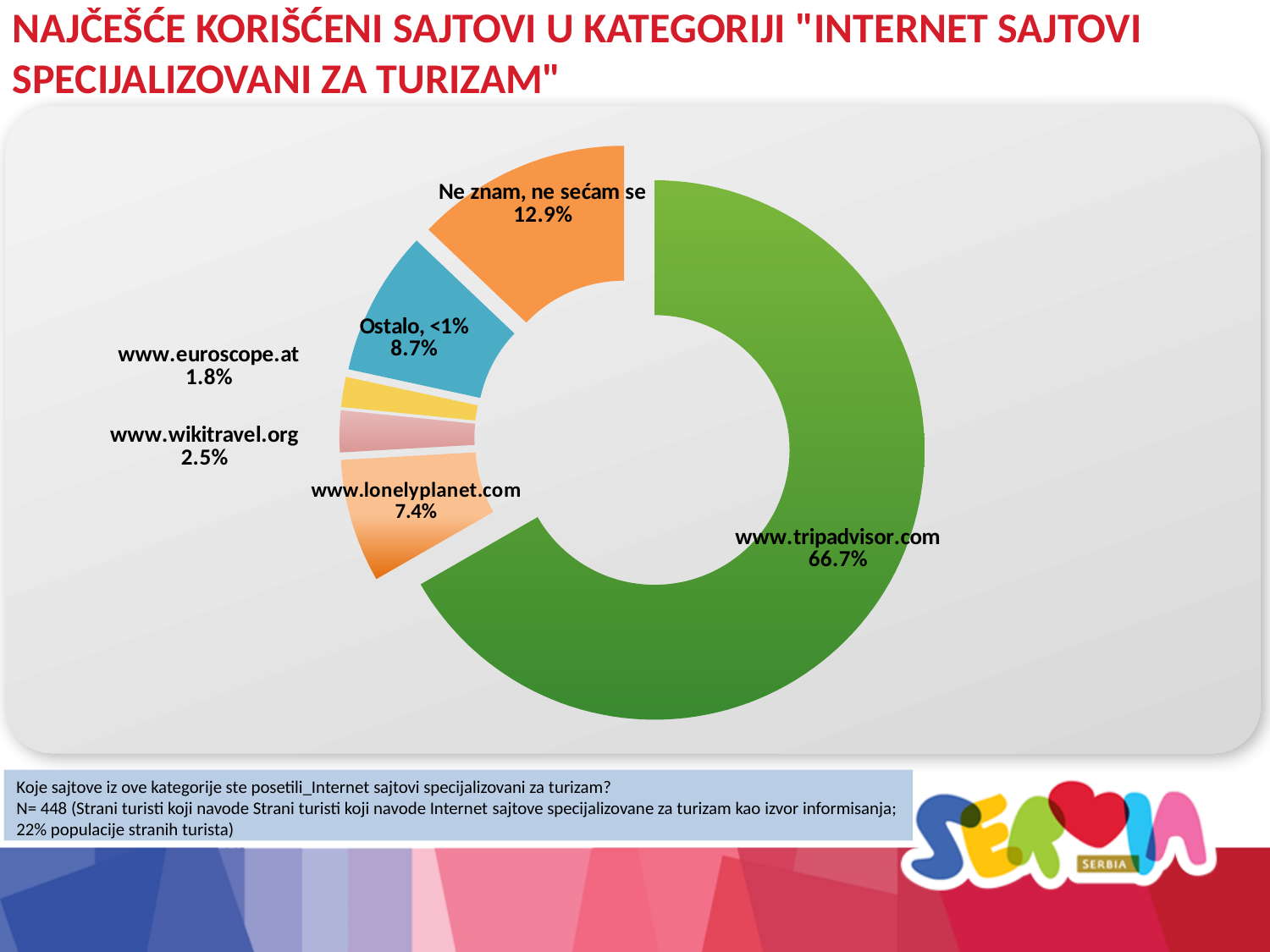
How many slices does the chart have? 6 What percentage is shown for www.euroscope.at? 1.8% What colour is the www.tripadvisor.com slice? Green Which category has the largest slice of the chart? www.tripadvisor.com Which is larger, the share for 'Ostalo, <1%' or the share for www.lonelyplanet.com? Ostalo, <1% What percentage is shown for www.lonelyplanet.com? 7.4% What share of respondents is shown for www.tripadvisor.com? 66.7% What is the difference in percentage points between www.tripadvisor.com and 'Ne znam, ne sećam se'? 53.8 What percentage is shown for www.wikitravel.org? 2.5% What kind of chart is shown on the slide? Pie chart (doughnut) What percentage is shown for the 'Ne znam, ne sećam se' slice? 12.9% Which category has the smallest slice of the chart? www.euroscope.at